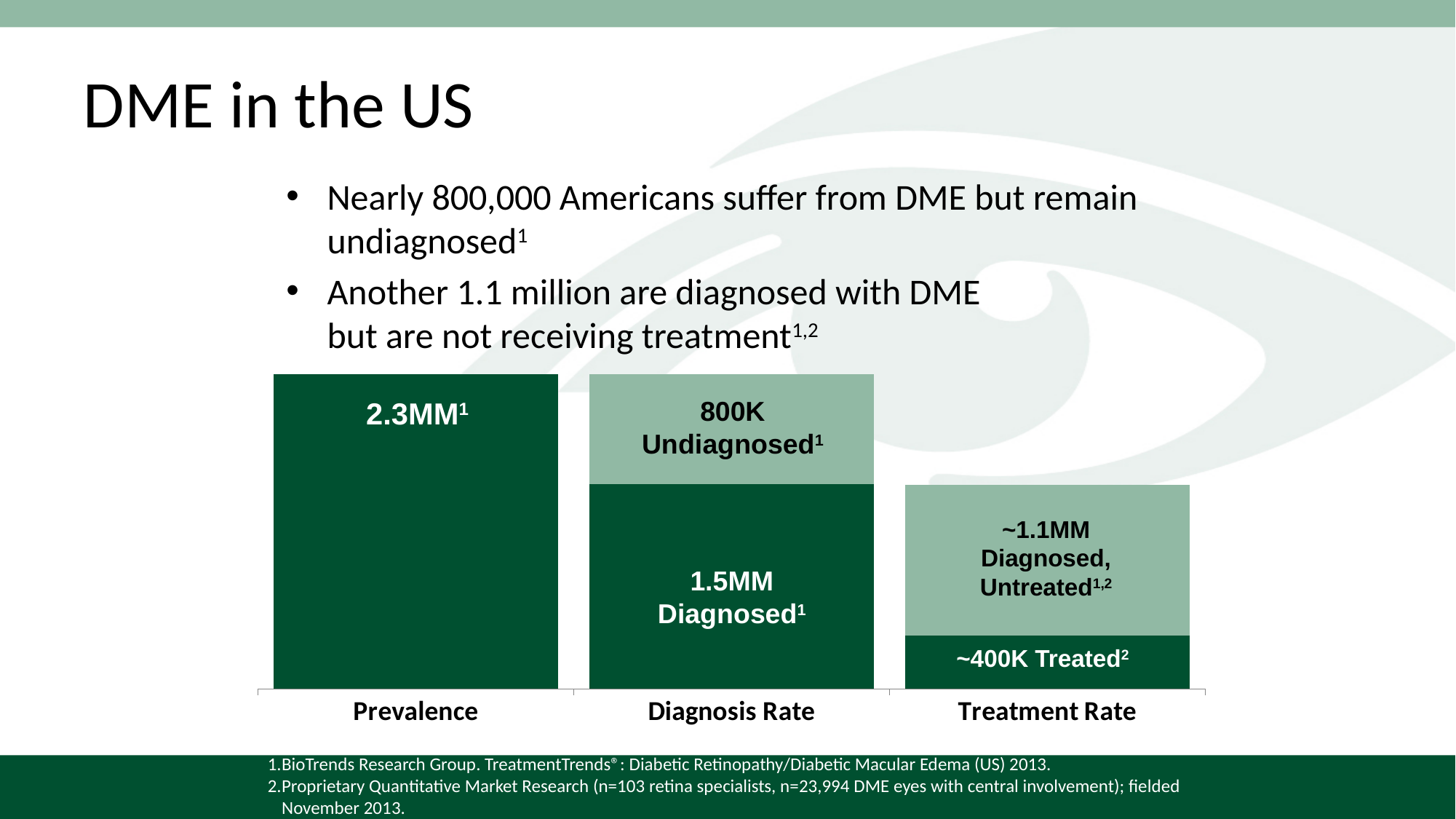
What is the total of the Diagnosis Rate stacked bar (Diagnosed plus Undiagnosed)? 2.3MM What value is printed for the Diagnosed, Untreated segment of the Treatment Rate bar? ~1.1MM What value is printed on the Prevalence bar? 2.3MM Which category has the shortest bar? Treatment Rate How many categories are shown on the x axis? 3 In the Diagnosis Rate bar, which segment is larger: Diagnosed or Undiagnosed? Diagnosed What value is printed for the Diagnosed segment of the Diagnosis Rate bar? 1.5MM What value is printed for the Treated segment of the Treatment Rate bar? ~400K What kind of chart is shown on the slide? Bar chart Do the bar heights rise or fall from Prevalence to Treatment Rate? Fall What value is printed for the Undiagnosed segment of the Diagnosis Rate bar? 800K